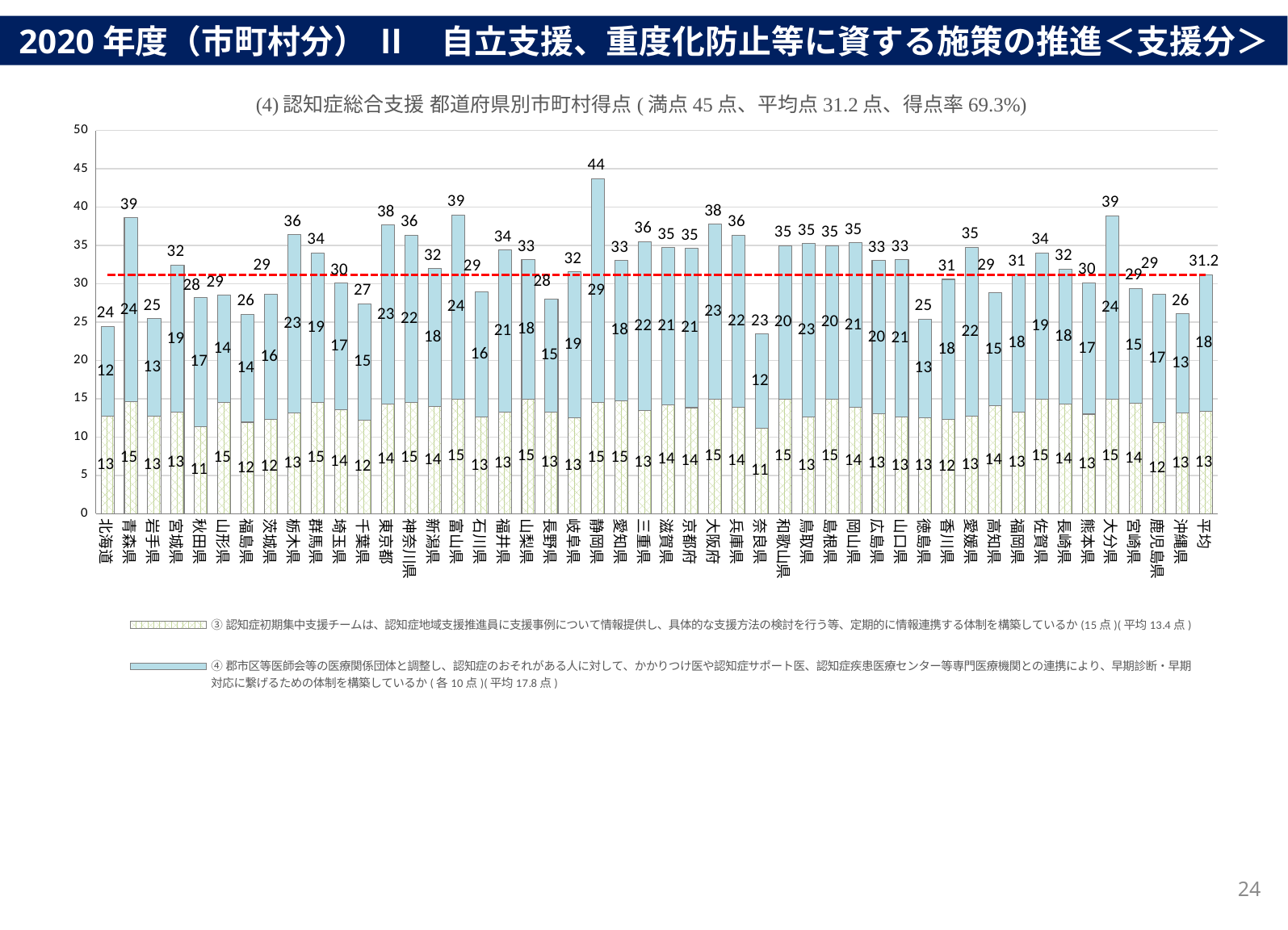
What is the difference between the total score of 静岡県 and that of 奈良県? 21 What is the total score shown for the 平均 (average) bar? 31.2 Which has a higher total score, 東京都 or 大阪府? They are equal (38) What is the value of the ③ (hatched) segment for 秋田県? 11 Which has a higher total score, 北海道 or 富山県? 富山県 What is the total score shown above the bar for 静岡県? 44 What kind of chart is shown on the slide? Stacked bar chart What is the value of the ④ (blue) segment for 青森県? 24 What is the total score shown above the bar for 沖縄県? 26 Which prefecture has the lowest total score in the chart? 奈良県 How many series does the legend list? 2 Which prefecture has the highest total score in the chart? 静岡県